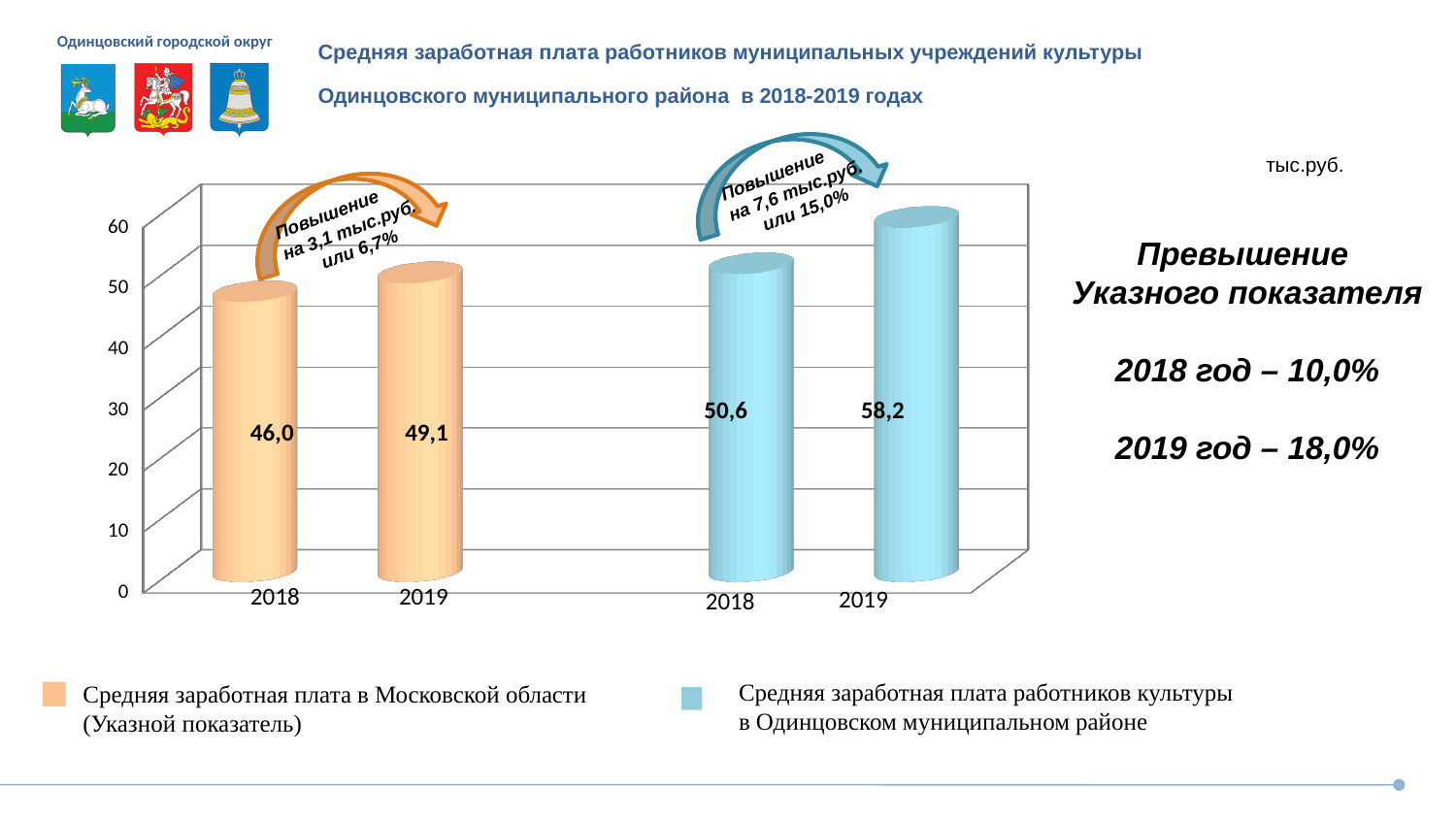
By how much did the average salary of Odintsovo culture workers increase from 2018 to 2019? 7,6 Is the value for Odintsovo culture workers in 2019 greater or less than 50? greater Which bar on the chart has the lowest value? Moscow region, 2018 (46,0) What is the average salary of culture workers in the Odintsovo municipal district in 2019? 58,2 What type of chart is shown on the slide? Bar chart What is the average salary in the Moscow region (Указной показатель) in 2018 according to the chart? 46,0 Which is larger in 2019: the Moscow region average salary or the Odintsovo culture workers' salary? Odintsovo culture workers' salary Which bar on the chart has the highest value? Odintsovo culture workers, 2019 (58,2) What is the value of the Moscow region average salary bar for 2019? 49,1 What is the value of the Odintsovo culture workers' salary bar for 2018? 50,6 How many series does the legend list? 2 By how much did the Moscow region average salary increase from 2018 to 2019? 3,1